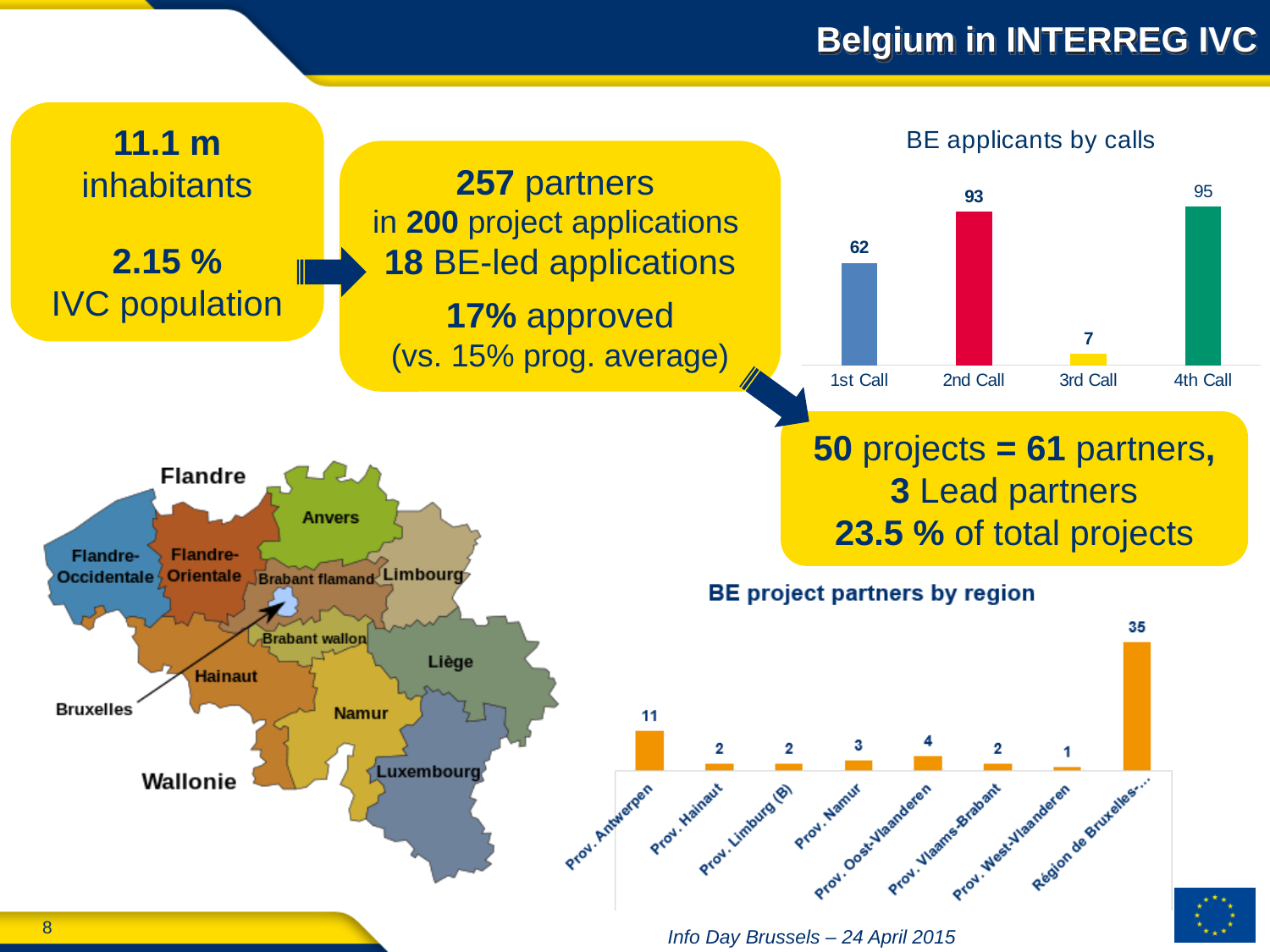
In the 'BE project partners by region' chart, how many regions are shown? 8 In the 'BE project partners by region' chart, what is the difference between Région de Bruxelles-... and Prov. Antwerpen? 24 In the 'BE project partners by region' chart, is the value for Prov. Oost-Vlaanderen larger than the value for Prov. Namur? Yes What type of chart is 'BE applicants by calls'? Bar chart In the 'BE applicants by calls' chart, how many calls are shown? 4 In the 'BE applicants by calls' chart, which call has the highest number of applicants? 4th Call In the 'BE applicants by calls' chart, which call has the lowest number of applicants? 3rd Call In the 'BE project partners by region' chart, which region has the lowest value? Prov. West-Vlaanderen In the 'BE applicants by calls' chart, what is the value for the 2nd Call? 93 In the 'BE applicants by calls' chart, what is the difference between the 1st Call and the 3rd Call values? 55 In the 'BE project partners by region' chart, which region has the highest value? Région de Bruxelles-... In the 'BE project partners by region' chart, what is the value for Prov. Antwerpen? 11